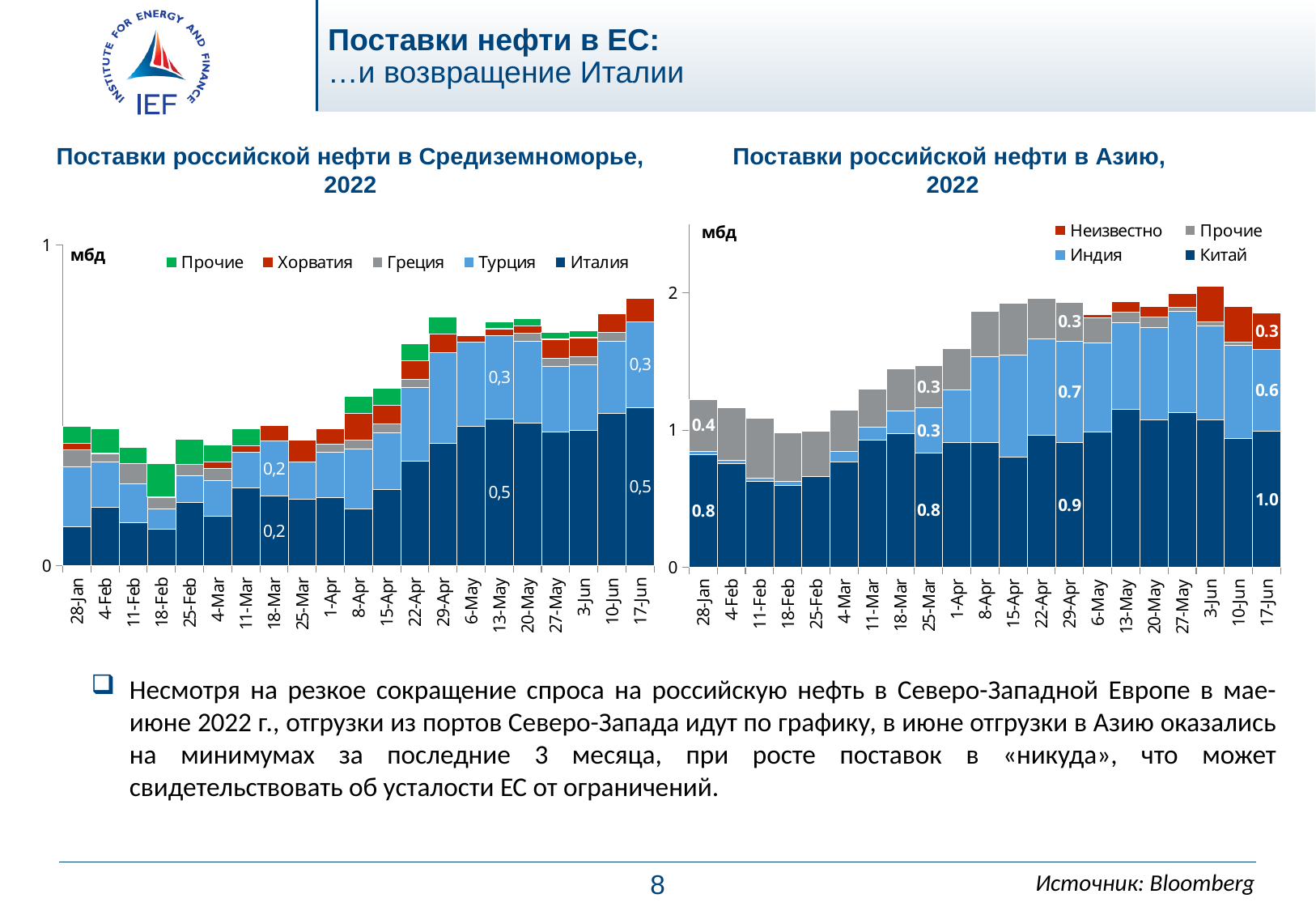
In 'Поставки российской нефти в Азию, 2022', what is the value for Китай on 17-Jun? 1.0 How many series does the legend of 'Поставки российской нефти в Азию, 2022' list? 4 How many dates are shown on the x axis of 'Поставки российской нефти в Средиземноморье, 2022'? 21 In 'Поставки российской нефти в Средиземноморье, 2022', what is the value for Италия on 13-May? 0,5 In 'Поставки российской нефти в Азию, 2022', what is the value for Индия on 29-Apr? 0.7 What kind of chart is 'Поставки российской нефти в Средиземноморье, 2022'? stacked bar chart How many series does the legend of 'Поставки российской нефти в Средиземноморье, 2022' list? 5 In 'Поставки российской нефти в Азию, 2022', what is the difference between the Индия value on 29-Apr and on 17-Jun? 0.1 In 'Поставки российской нефти в Азию, 2022', is the value for Китай larger on 28-Jan or on 17-Jun? 17-Jun In 'Поставки российской нефти в Средиземноморье, 2022', what is the value for Турция on 18-Mar? 0,2 In 'Поставки российской нефти в Азию, 2022', what is the value for Прочие on 28-Jan? 0.4